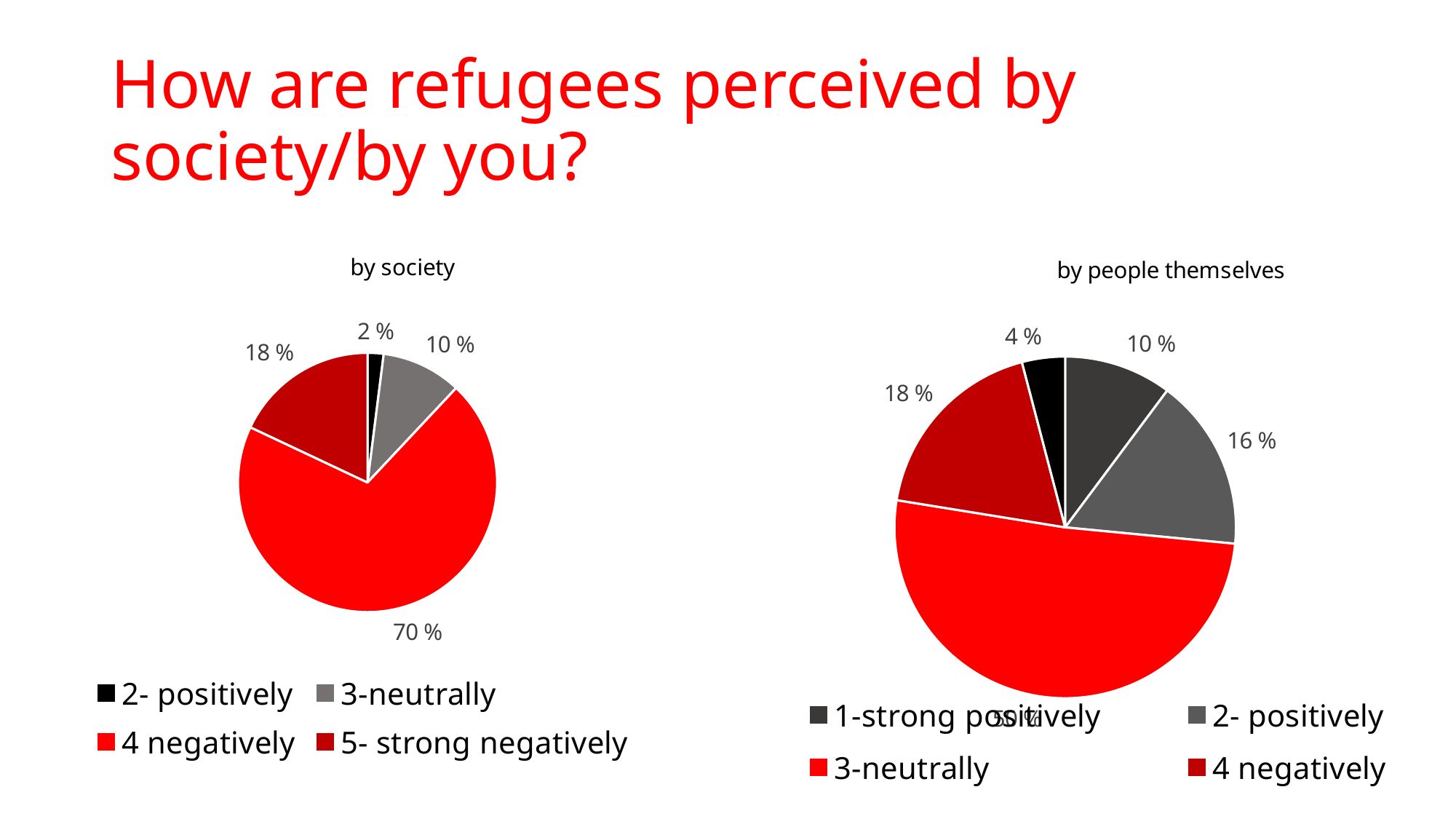
What kind of chart is the "by society" chart? pie chart In the "by people themselves" chart, what percentage is shown for "2- positively"? 16 % In the "by people themselves" chart, what percentage is shown for "1-strong positively"? 10 % How many entries does the legend of the "by society" chart list? 4 In the "by society" chart, which category has the largest slice? 4 negatively In the "by society" chart, what percentage is shown for "2- positively"? 2 % In the "by people themselves" chart, which category has the largest slice? 3-neutrally In the "by society" chart, what percentage is shown for "4 negatively"? 70 % In the "by people themselves" chart, what percentage is shown for "4 negatively"? 18 % In the "by society" chart, which category has the smallest slice? 2- positively In the "by society" chart, what is the difference between the "4 negatively" and "5- strong negatively" slices? 52 % In the "by society" chart, what percentage is shown for "5- strong negatively"? 18 %